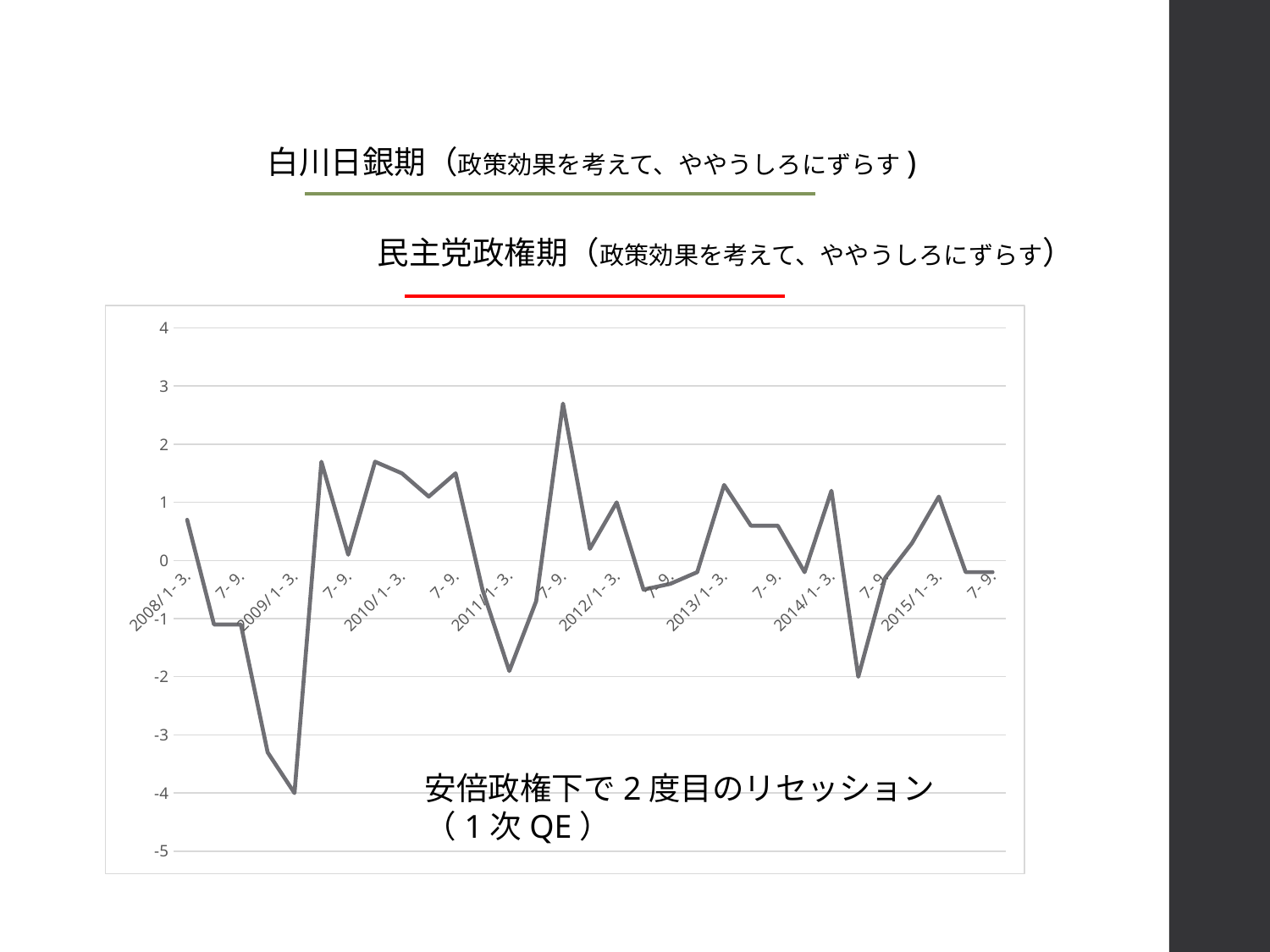
What is the highest value shown on the y axis? 4 What kind of chart is shown on the slide? line chart Is the value at 2008/1-3 greater or less than 0? greater At which x-axis label does the line reach its lowest point? 2009/1-3 Is the value at 2014/1-3 greater or less than 0? greater Does the line rise or fall from 2008/1-3 to 2009/1-3? fall What is the lowest value shown on the y axis? -5 Is the value at 2011 7-9 greater or less than 2? greater How many labels are shown on the x axis? 16 At which x-axis label does the line reach its highest point? 2011 7-9 Which is lower, the value at 2009/1-3 or the value at 2011/1-3? 2009/1-3